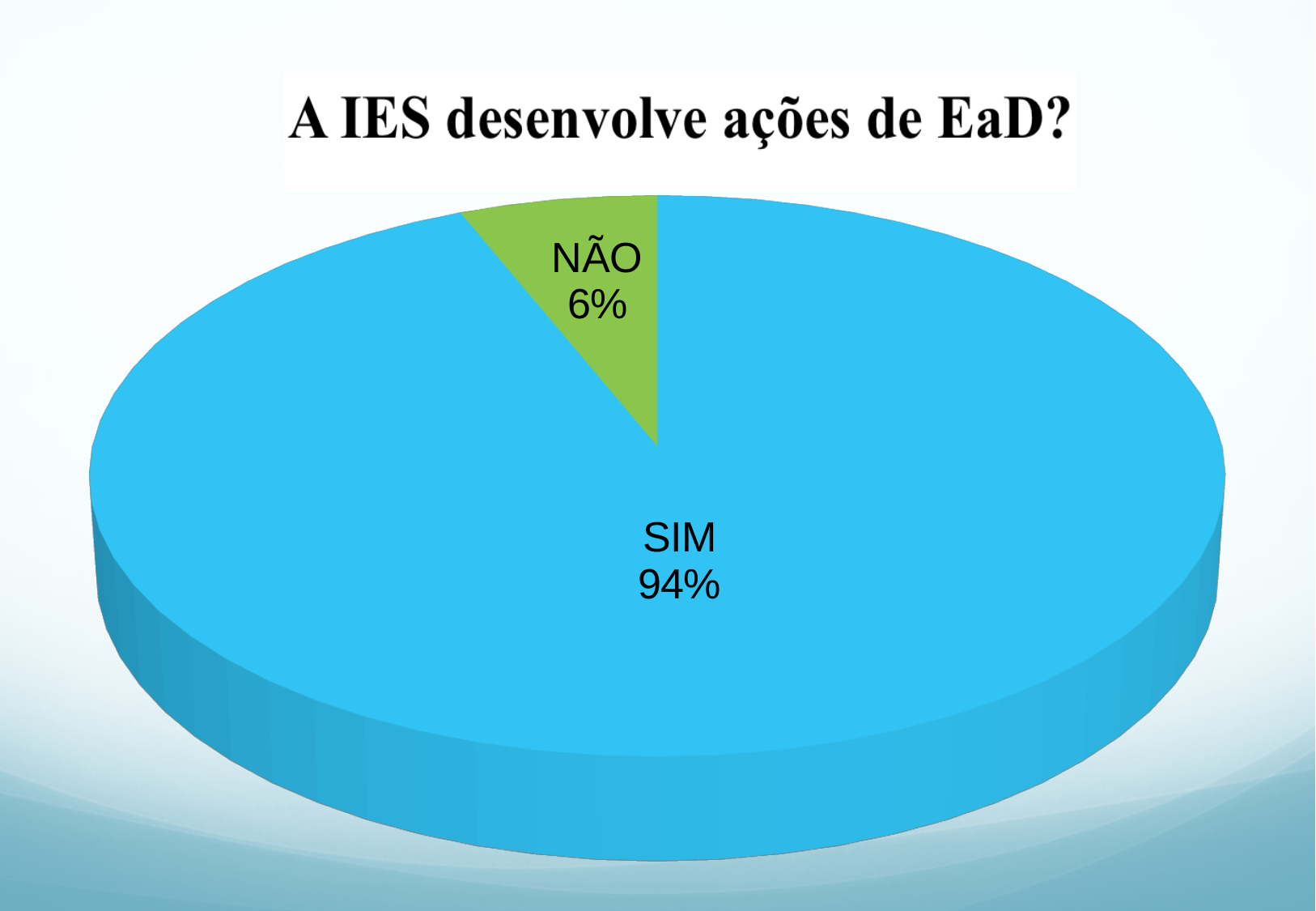
Which slice is the smallest? NÃO Which is larger, SIM or NÃO? SIM What kind of chart is shown on the slide? pie chart What share of the pie does NÃO represent? 6% What is the title of the chart? A IES desenvolve ações de EaD? What share of the pie does SIM represent? 94% Which slice is the largest? SIM What is the total of the two slices' percentages? 100% How many slices does the pie chart have? 2 What colour is the NÃO slice? green What is the difference in percentage points between SIM and NÃO? 88